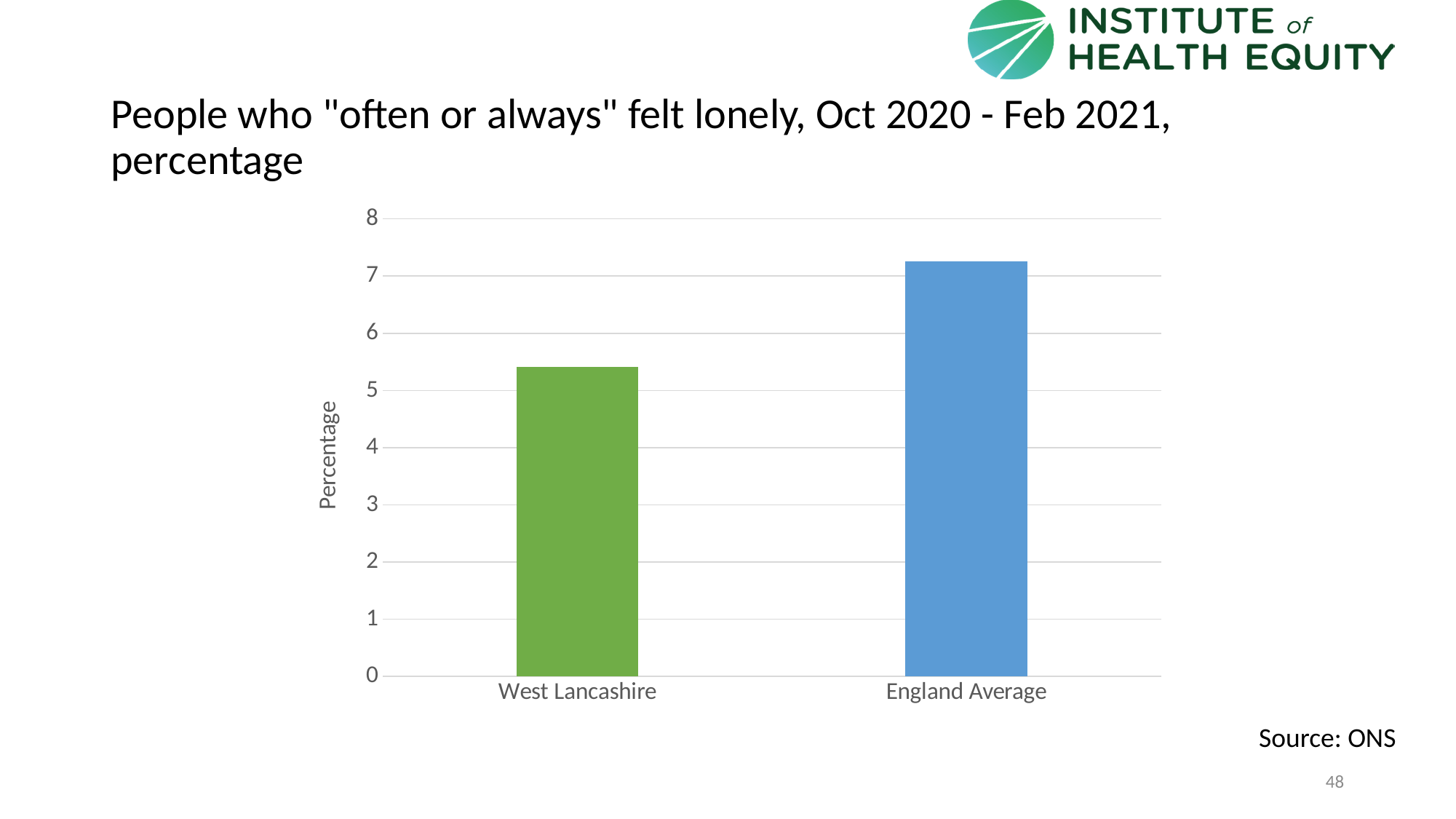
What kind of chart is shown on the slide? bar chart What colour is the bar for West Lancashire? green What is the label on the vertical axis? Percentage Is the value for England Average greater or less than 7? greater What is the source cited for the chart? ONS Which category has the lowest value? West Lancashire Is the value for West Lancashire greater or less than 6? less How many categories are plotted on the chart? 2 Which category has the highest value? England Average Is the value for West Lancashire greater or less than 5? greater Which is larger, the value for West Lancashire or the value for England Average? England Average